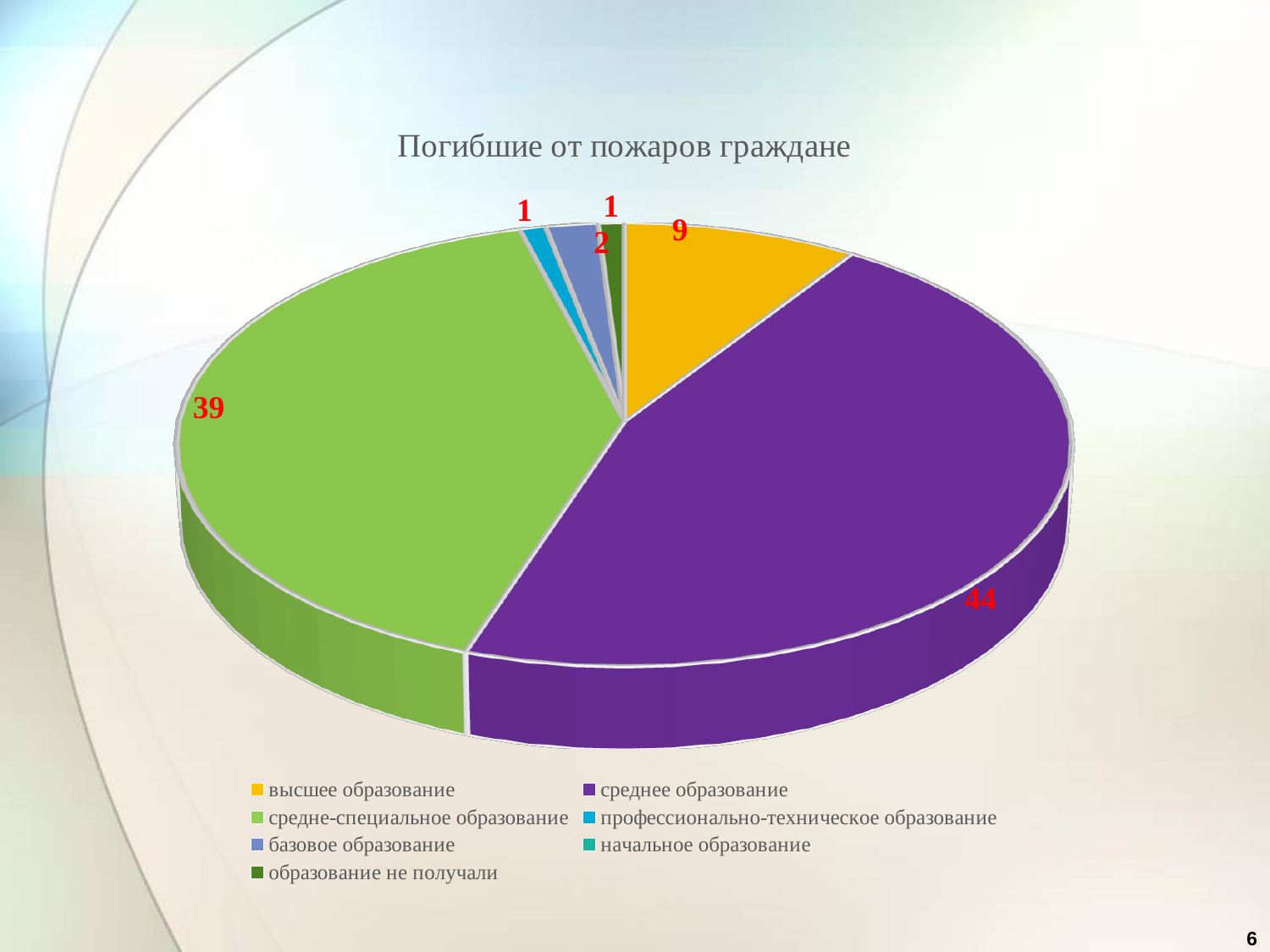
What is the difference between the values for среднее образование and средне-специальное образование? 5 How many categories does the legend list? 7 Which category has the largest slice? среднее образование What is the value for базовое образование? 2 What is the difference between the values for средне-специальное образование and высшее образование? 30 What colour is the slice for среднее образование? purple What is the value for высшее образование? 9 What is the title of the chart? Погибшие от пожаров граждане What kind of chart is shown on the slide? pie chart Which is larger, the value for высшее образование or the value for базовое образование? высшее образование What is the value for среднее образование? 44 What is the value for средне-специальное образование? 39